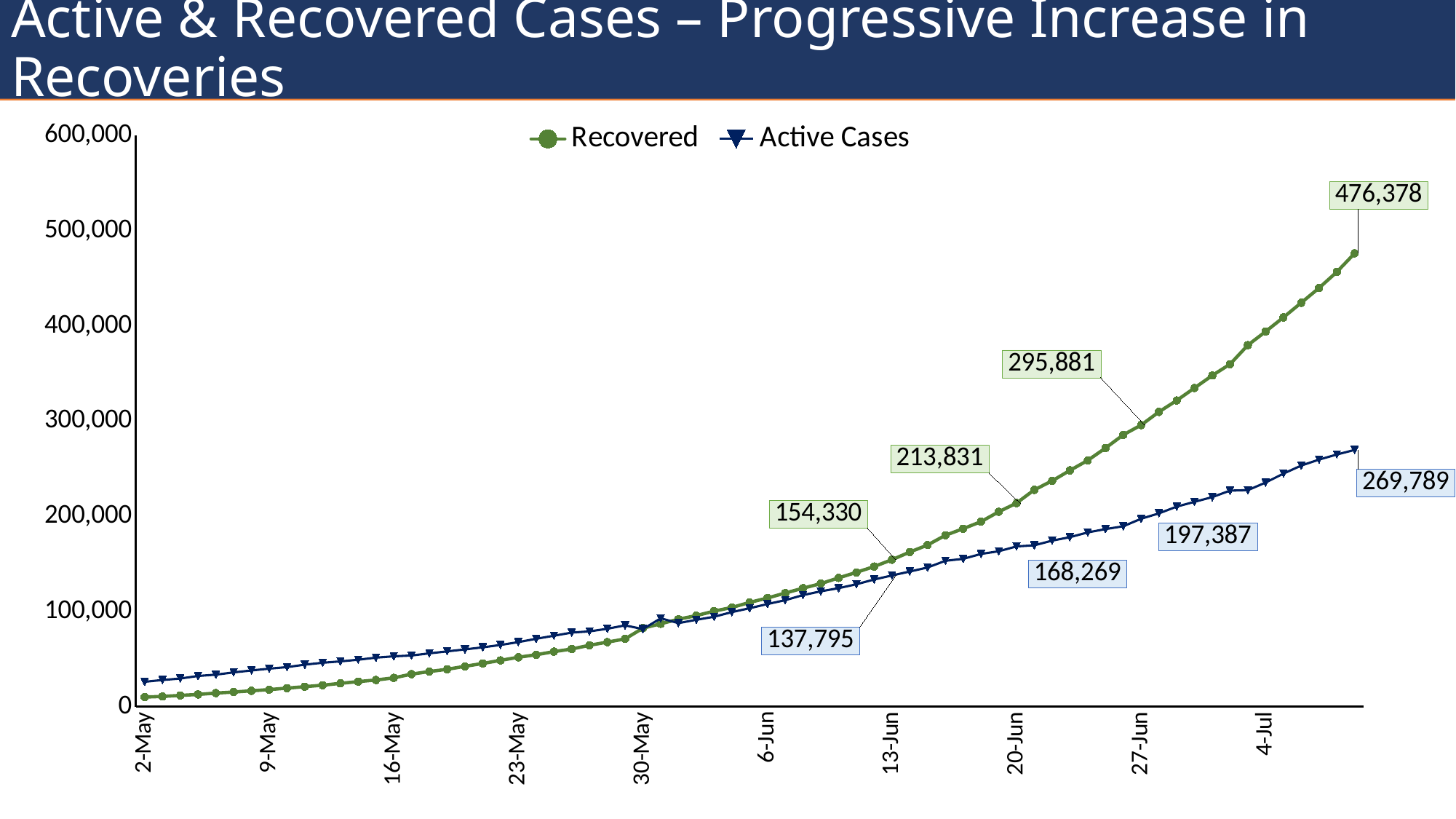
What is the final labelled value of the Recovered series? 476,378 What is the labelled Recovered value around 20-Jun? 213,831 Do the Recovered values rise or fall from 2-May to the end of the chart? Rise What is the difference between the final labelled Recovered value (476,378) and the final labelled Active Cases value (269,789)? 206,589 What is the final labelled value of the Active Cases series? 269,789 Which series has the higher value on 2-May, Recovered or Active Cases? Active Cases What is the labelled Active Cases value around 27-Jun? 197,387 What is the difference between the labelled Recovered value 154,330 and the labelled Active Cases value 137,795 around 13-Jun? 16,535 Is the Recovered value on 4-Jul greater or less than 300,000? greater How many series does the legend list? 2 What colour is the Recovered line? Green What type of chart is shown on the slide? Line chart